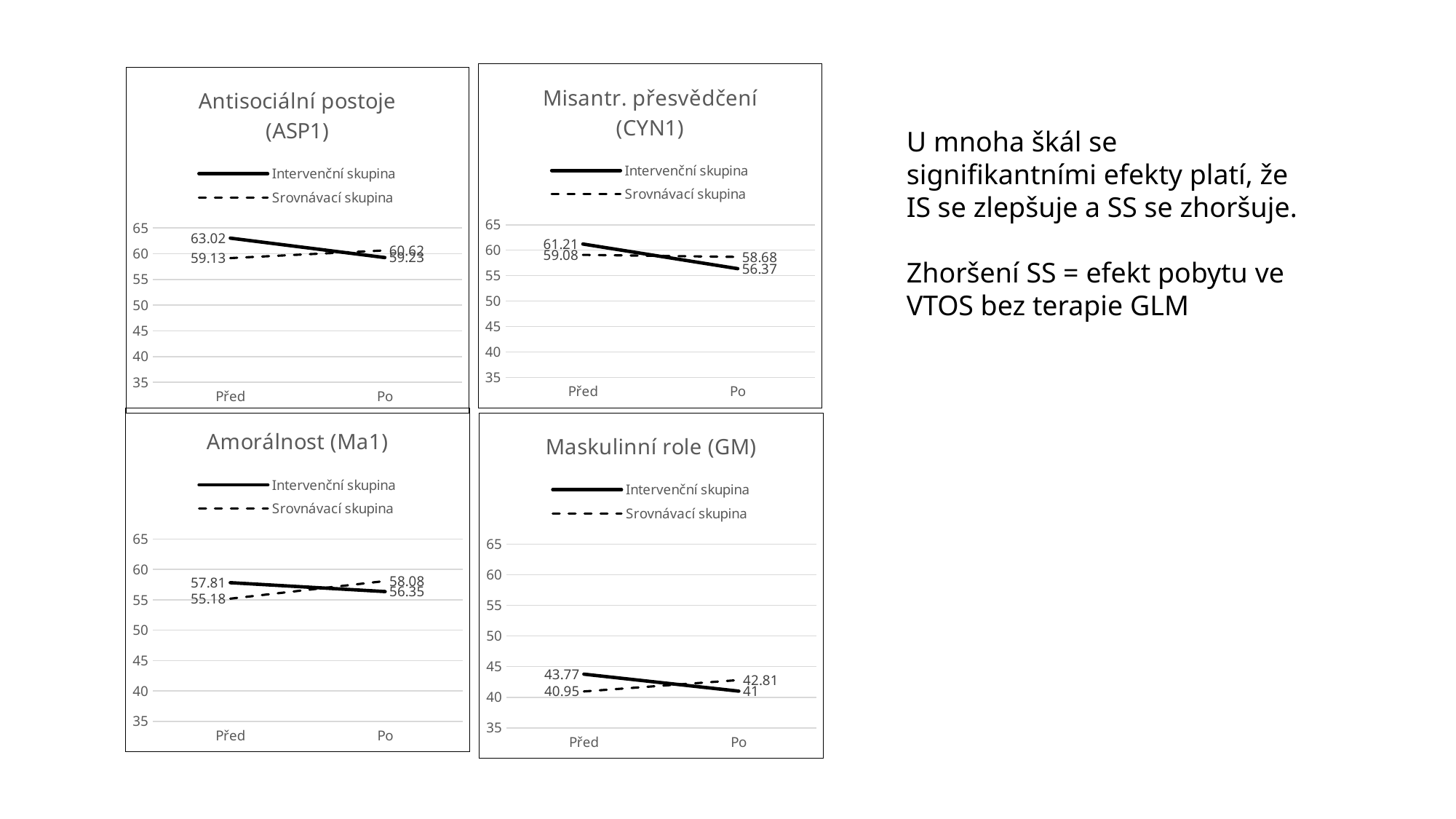
In the 'Misantr. přesvědčení (CYN1)' chart, what is the value for Intervenční skupina at Po? 56.37 In the 'Antisociální postoje (ASP1)' chart, what is the value for Srovnávací skupina at Po? 60.62 In the 'Amorálnost (Ma1)' chart, what is the value for Srovnávací skupina at Před? 55.18 How many series does the legend of the 'Amorálnost (Ma1)' chart list? 2 In the 'Maskulinní role (GM)' chart, is the value for Intervenční skupina at Před greater or less than 45? less What kind of chart is 'Misantr. přesvědčení (CYN1)'? line chart In the 'Antisociální postoje (ASP1)' chart, what is the difference between the two groups at Před? 3.89 In the 'Amorálnost (Ma1)' chart, which group has the higher value at Po? Srovnávací skupina In the 'Maskulinní role (GM)' chart, does the Srovnávací skupina value rise or fall from Před to Po? rise In the 'Maskulinní role (GM)' chart, what is the value for Intervenční skupina at Po? 41 In the 'Antisociální postoje (ASP1)' chart, what is the value for Intervenční skupina at Před? 63.02 In the 'Misantr. přesvědčení (CYN1)' chart, by how much does the Intervenční skupina value drop from Před to Po? 4.84